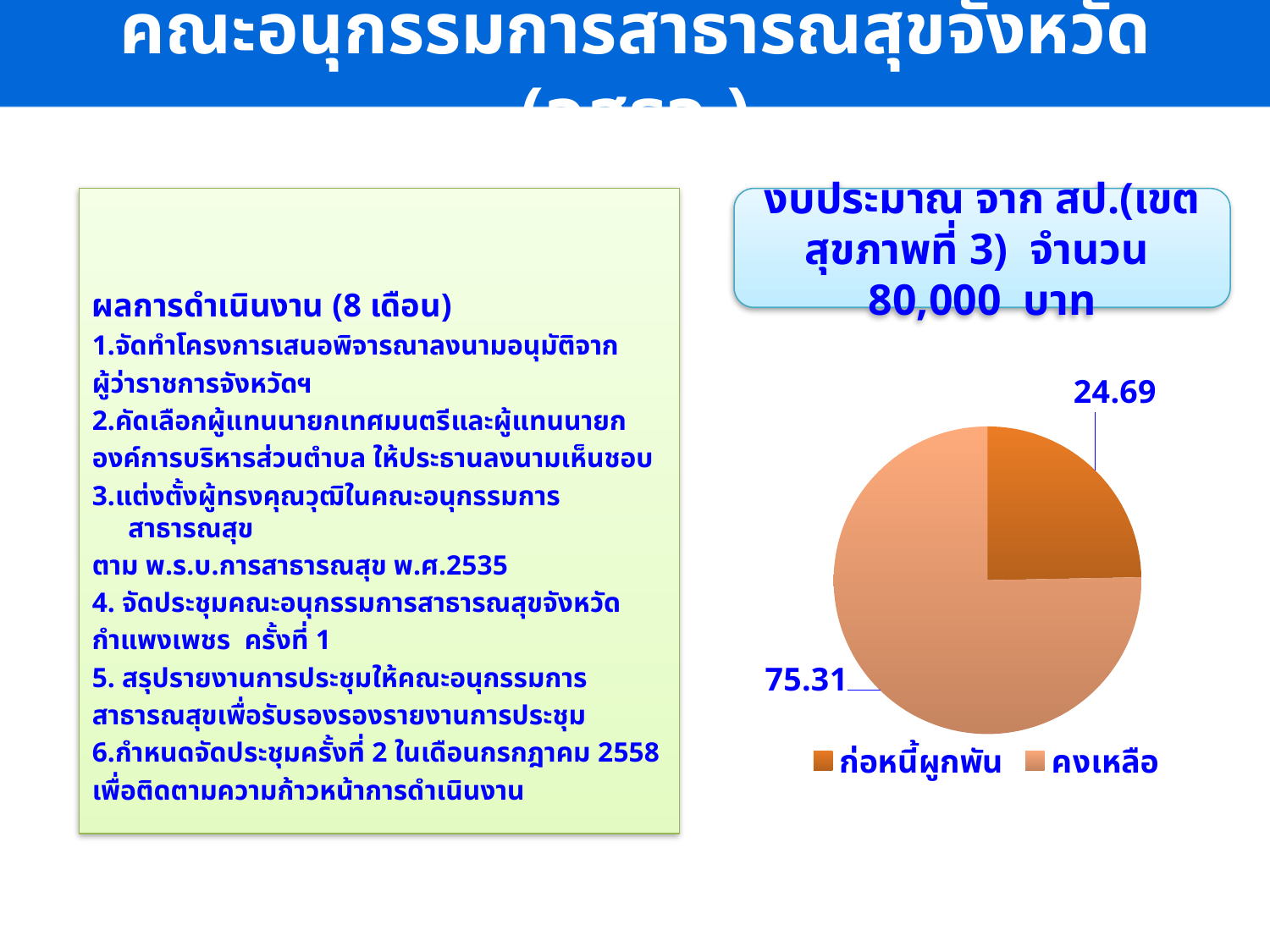
What kind of chart is shown on the slide? pie chart What is the value shown for คงเหลือ in the pie chart? 75.31 Which legend entry of the pie chart is shown in the darker orange colour? ก่อหนี้ผูกพัน How many slices does the pie chart have? 2 How many entries does the legend of the pie chart list? 2 What is the total of the two values shown in the pie chart? 100 Which slice of the pie chart is the largest? คงเหลือ What is the difference between the values for คงเหลือ and ก่อหนี้ผูกพัน in the pie chart? 50.62 Which is larger in the pie chart, ก่อหนี้ผูกพัน or คงเหลือ? คงเหลือ Which slice of the pie chart is the smallest? ก่อหนี้ผูกพัน What is the value shown for ก่อหนี้ผูกพัน in the pie chart? 24.69 According to the box above the pie chart, what is the total budget amount from สป.(เขตสุขภาพที่ 3)? 80,000 บาท